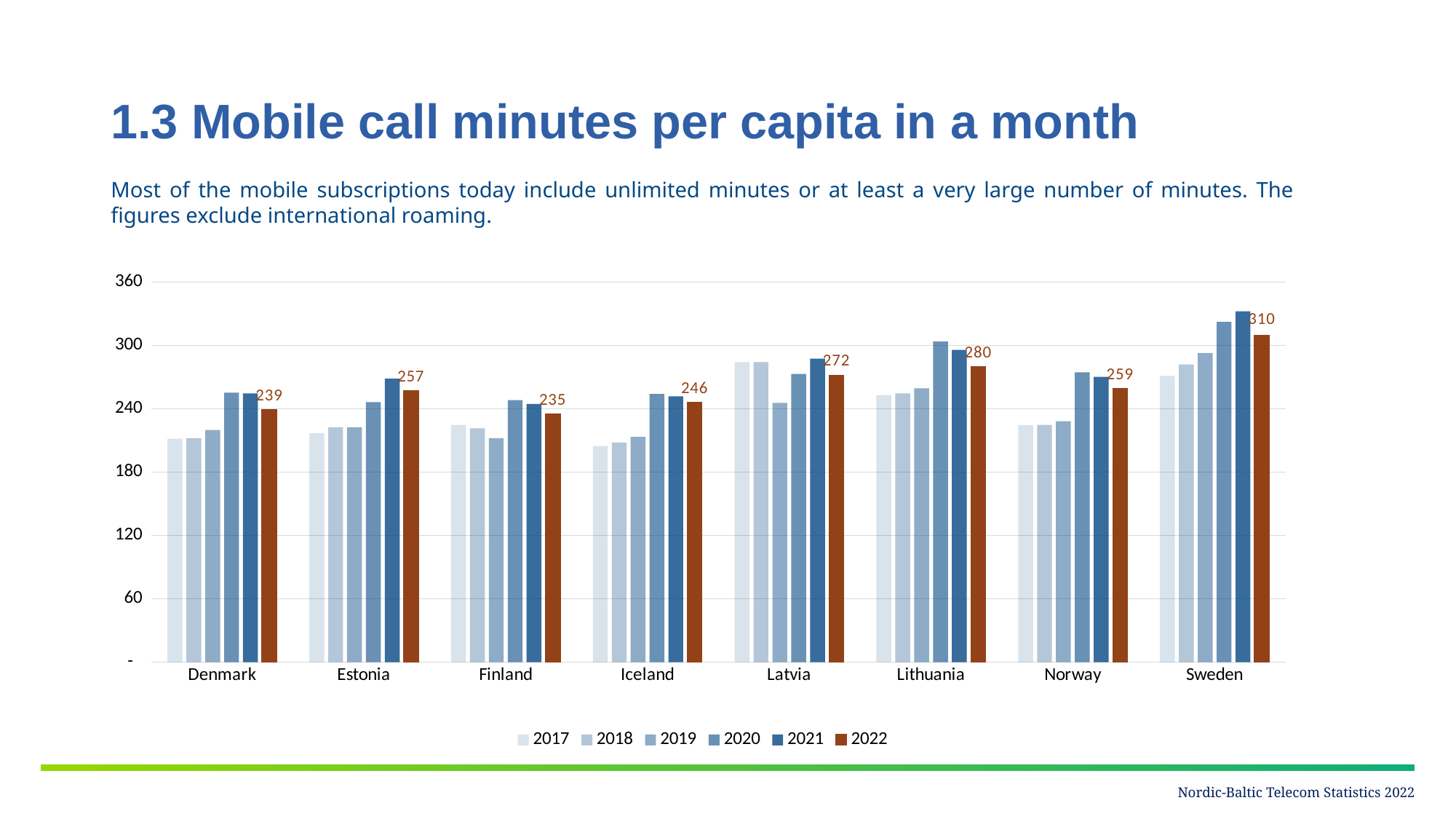
Which country has the lowest value in 2022? Finland How many series does the legend list? 6 What is the value for Lithuania in 2022? 280 Which country has the highest value in 2022? Sweden What is the value for Finland in 2022? 235 Which is larger in 2022, Latvia or Norway? Latvia Is the value for Iceland in 2017 greater or less than 240? less What is the value for Sweden in 2022? 310 What is the difference between the 2022 values for Sweden and Denmark? 71 Is the value for Sweden in 2021 greater or less than 300? greater How many countries are shown on the x axis? 8 What kind of chart is shown on the slide? Bar chart